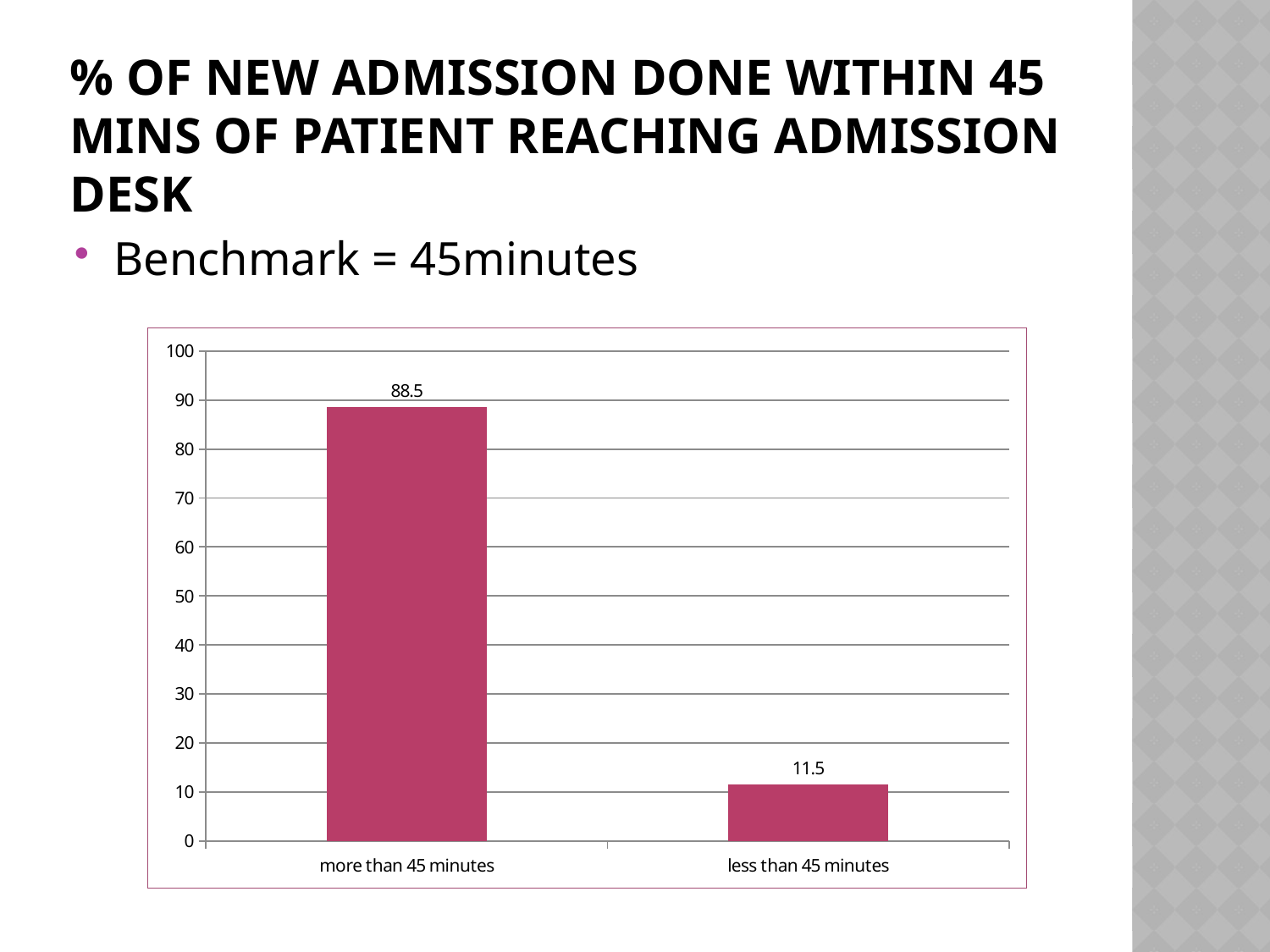
What is the highest value shown on the y axis? 100 How many categories are shown on the x axis? 2 Which category has the highest value? more than 45 minutes Which is larger, the value for "more than 45 minutes" or the value for "less than 45 minutes"? more than 45 minutes What is the value for "less than 45 minutes"? 11.5 What is the value for "more than 45 minutes"? 88.5 What is the total of the two bar values? 100 Is the value for "less than 45 minutes" greater or less than 20? less What kind of chart is shown on the slide? bar chart Which category has the lowest value? less than 45 minutes What is the difference between the values for "more than 45 minutes" and "less than 45 minutes"? 77 Is the value for "more than 45 minutes" greater or less than 80? greater